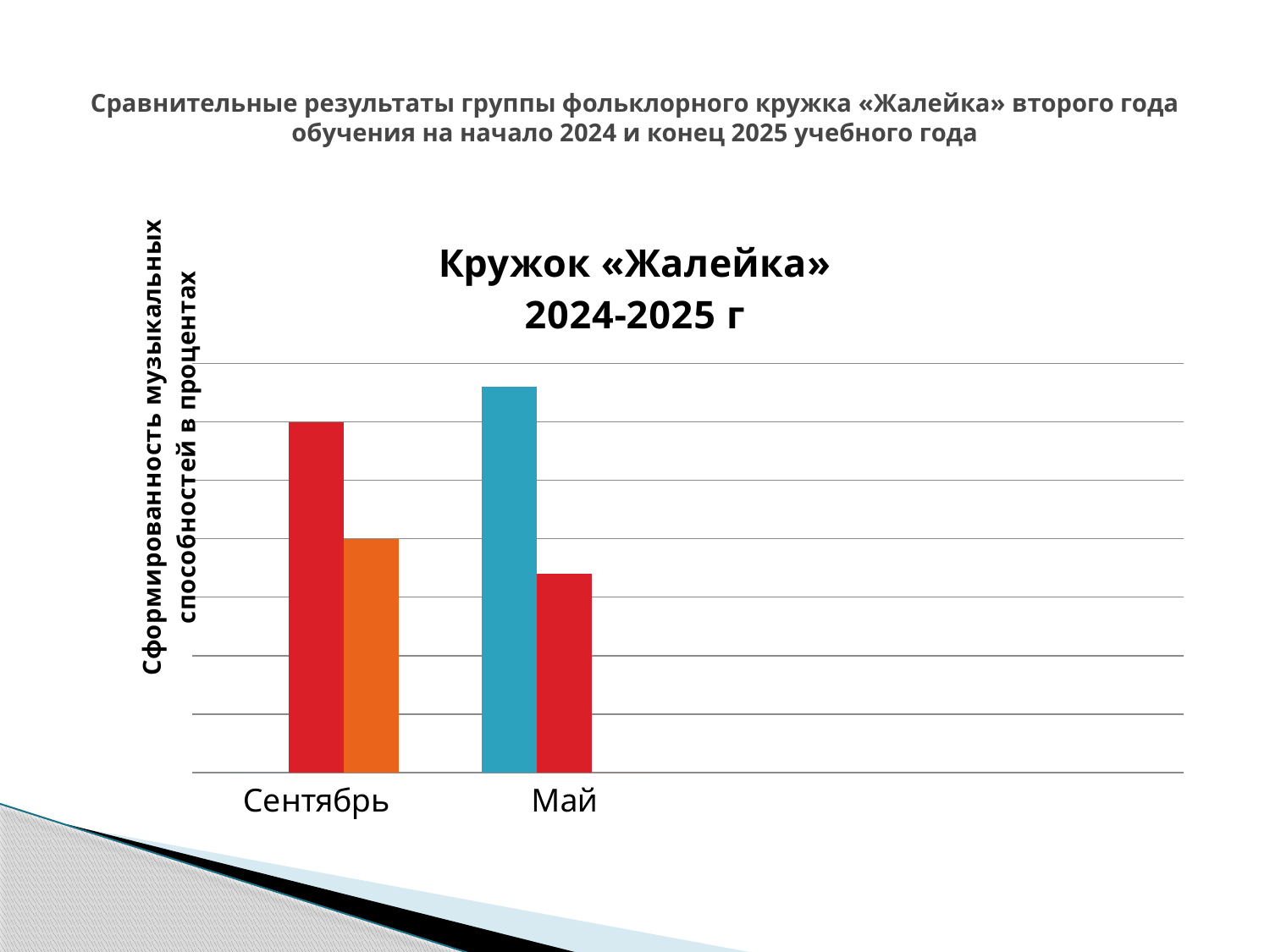
In the Сентябрь category, which bar is taller, the red one or the orange one? the red one Which category contains the tallest bar in the chart, Сентябрь or Май? Май What are the two categories on the x axis of the chart? Сентябрь and Май Is the first (left) bar for Май taller or shorter than the first (left) bar for Сентябрь? taller Is the second (right) bar for Май taller or shorter than the second (right) bar for Сентябрь? shorter How many categories are shown on the x axis of the chart? 2 What is the title of the chart? Кружок «Жалейка» 2024-2025 г What kind of chart is shown on the slide? bar chart How many bars are plotted in the chart in total? 4 Which bar is the shortest in the chart? the red bar for Май